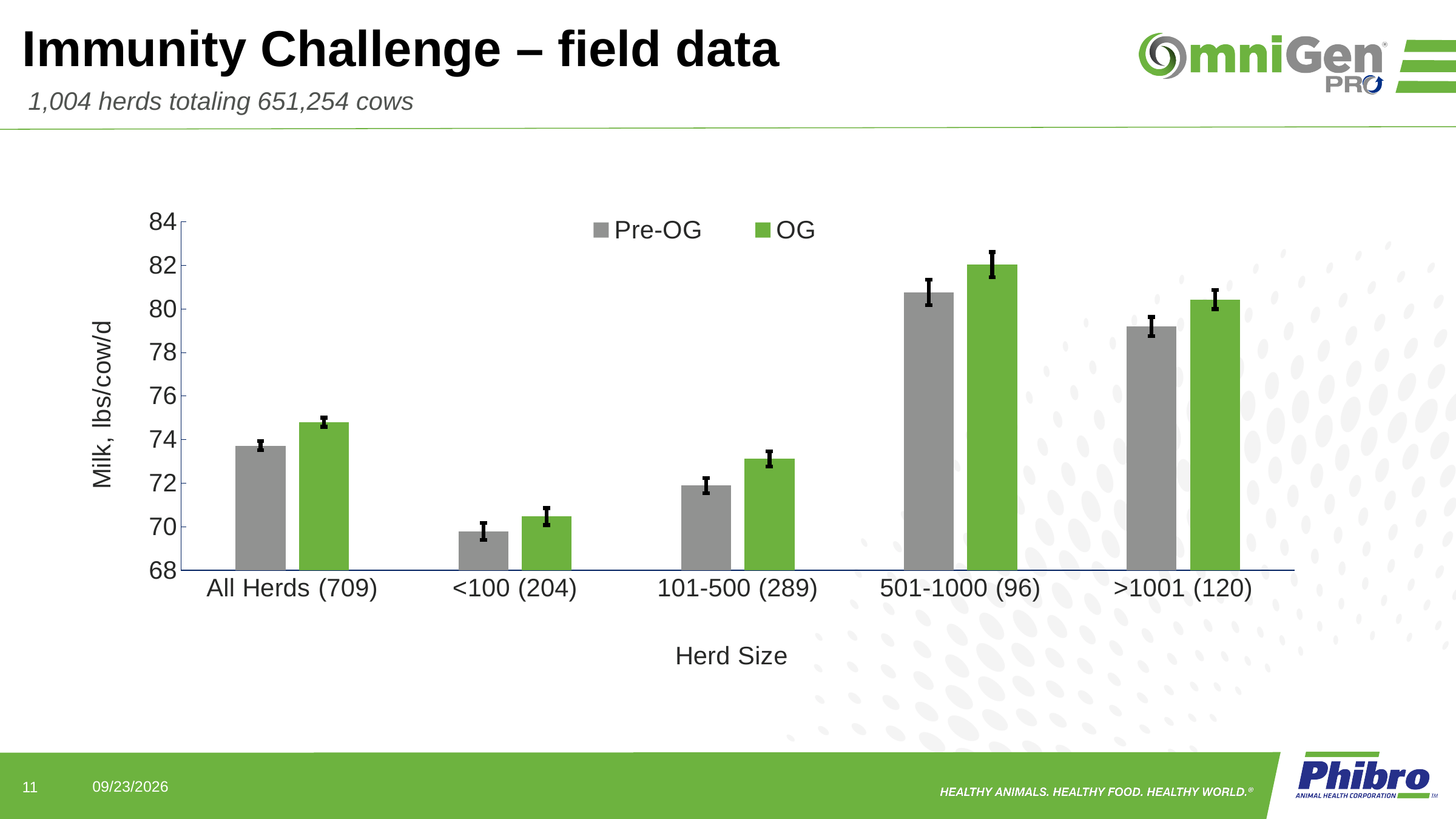
How many series does the legend list? 2 What is the title of the x axis? Herd Size Is the Pre-OG value for <100 (204) greater or less than 72? less Is the Pre-OG value for All Herds (709) greater or less than 72? greater Which herd size category has the highest OG bar? 501-1000 (96) Is the OG value for 501-1000 (96) greater or less than 80? greater What is the label of the y axis? Milk, lbs/cow/d Which herd size category has the lowest Pre-OG bar? <100 (204) For the 501-1000 (96) category, which is larger, the Pre-OG value or the OG value? OG What kind of chart is shown on the slide? bar chart Which is larger, the OG value for 501-1000 (96) or the OG value for >1001 (120)? 501-1000 (96) How many herd size categories are shown on the x axis? 5